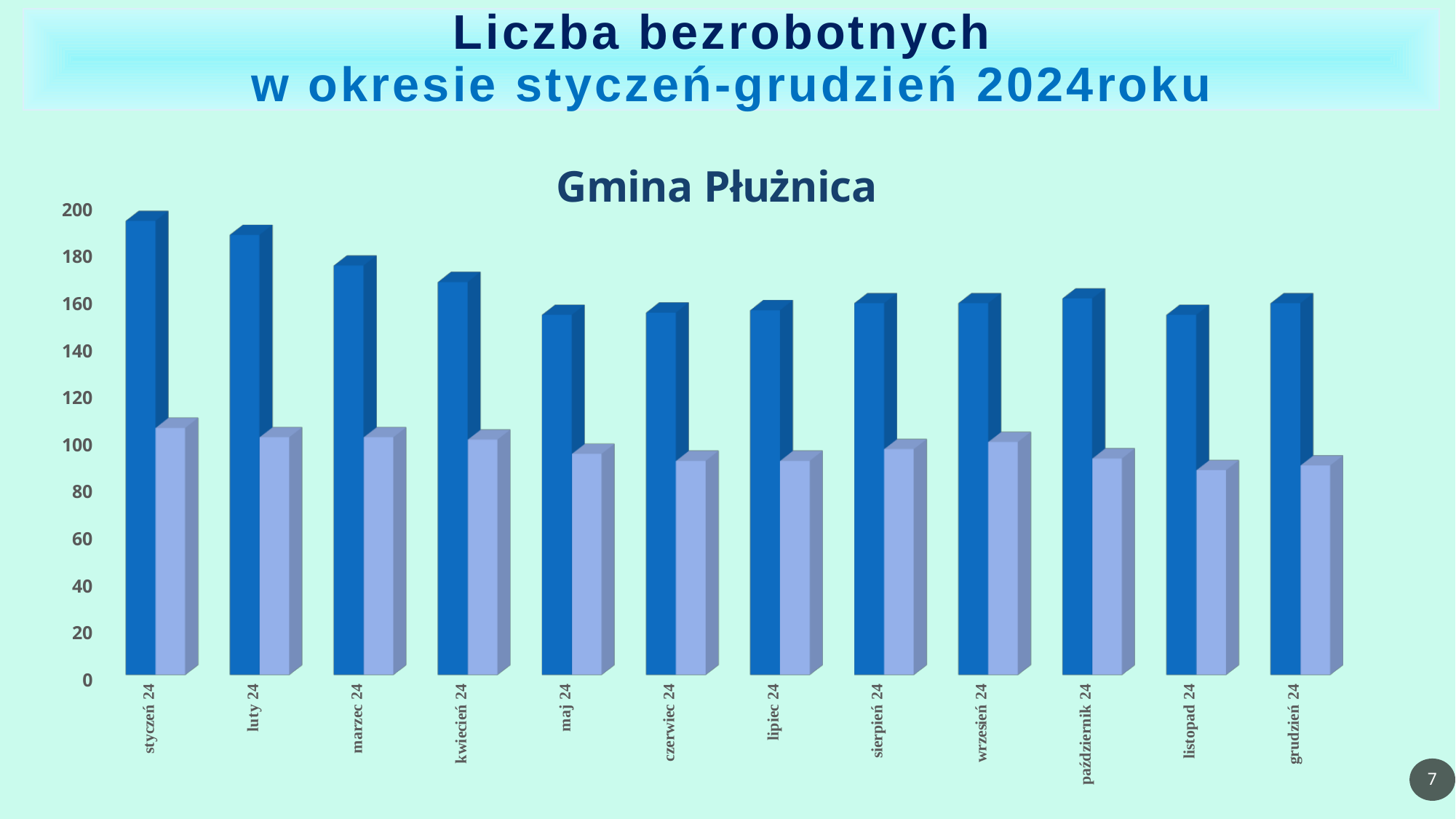
How many bars are plotted for each month? 2 Is the light blue bar for styczeń 24 greater or less than 100? greater Which is larger, the light blue bar for kwiecień 24 or the light blue bar for listopad 24? kwiecień 24 Is the light blue bar for czerwiec 24 greater or less than 100? less Is the dark blue bar for styczeń 24 greater or less than 180? greater What kind of chart is shown on the slide? bar chart What is the title of the chart? Gmina Płużnica How many months (categories) are shown on the x axis? 12 Which month has the highest dark blue bar? styczeń 24 Do the dark blue bars rise or fall from styczeń 24 to maj 24? fall Which is larger, the dark blue bar for styczeń 24 or the dark blue bar for grudzień 24? styczeń 24